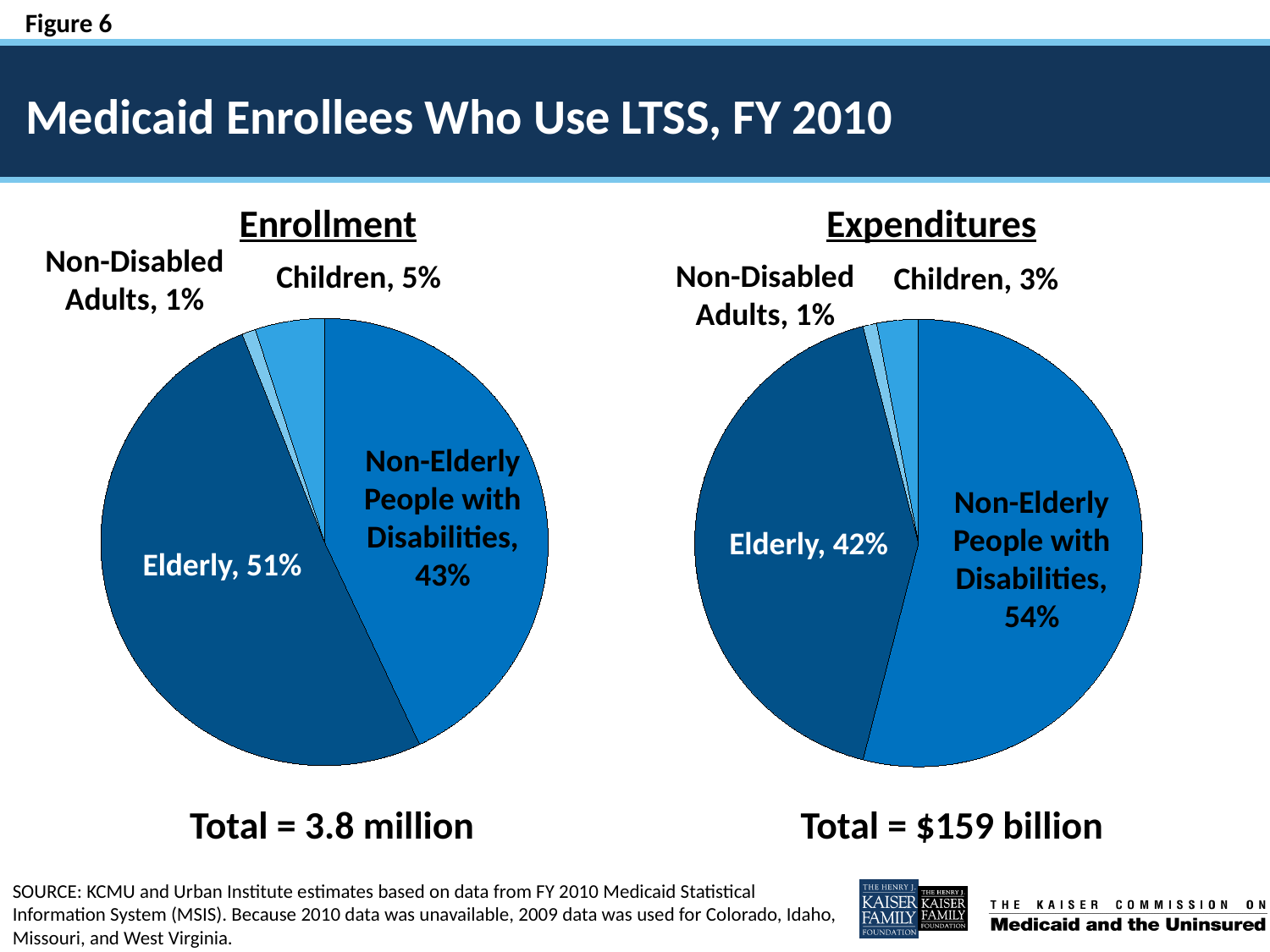
In the Expenditures pie chart, what share of expenditures goes to Non-Elderly People with Disabilities? 54% In the Enrollment pie chart, what share of enrollees are Children? 5% In the Expenditures pie chart, what is the difference between the Non-Elderly People with Disabilities share and the Elderly share? 12 percentage points What total is shown beneath the Expenditures pie chart? Total = $159 billion In the Enrollment pie chart, what share of enrollees are Elderly? 51% In the Expenditures pie chart, which group has the largest share? Non-Elderly People with Disabilities In the Enrollment pie chart, is the Elderly share larger or smaller than the Non-Elderly People with Disabilities share? larger In the Enrollment pie chart, which group has the smallest share? Non-Disabled Adults In the Enrollment pie chart, which group has the largest share? Elderly In the Expenditures pie chart, what share of expenditures goes to Children? 3% What type of chart is used to show Enrollment on this slide? pie chart How many slices does the Expenditures pie chart have? 4